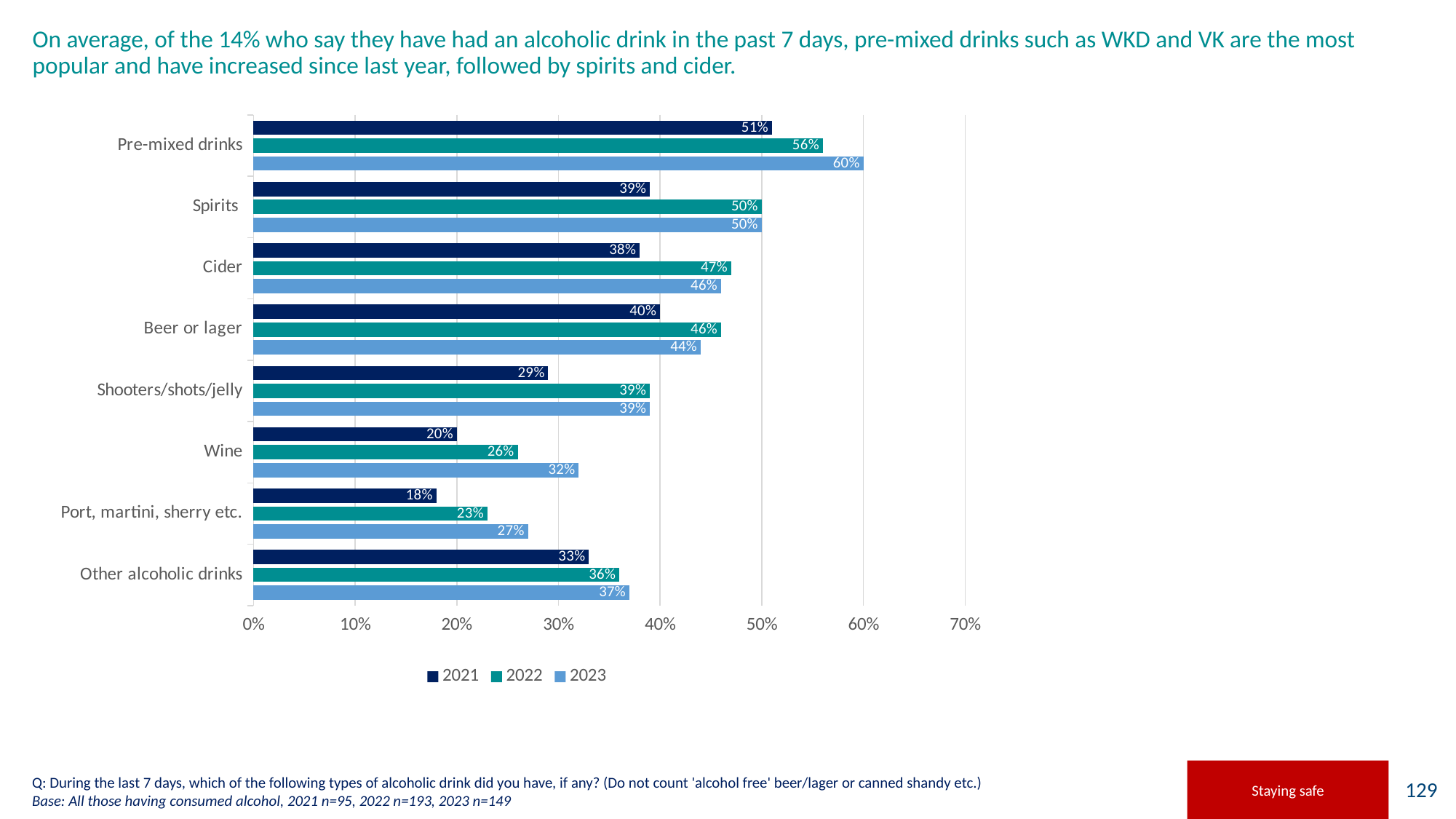
Which is larger for Beer or lager: the 2022 value or the 2023 value? 2022 What kind of chart is shown on the slide? Bar chart What is the 2022 value for Cider? 47% Which category has the highest 2023 value? Pre-mixed drinks How many drink categories are shown on the chart? 8 Is the 2021 value for Spirits greater or less than 30%? greater What is the difference between the 2023 and 2021 values for Wine? 12% What is the 2023 value for Pre-mixed drinks? 60% Which years are listed in the legend? 2021, 2022, 2023 How many series does the legend list? 3 What is the 2021 value for Wine? 20% Which category has the lowest 2021 value? Port, martini, sherry etc.